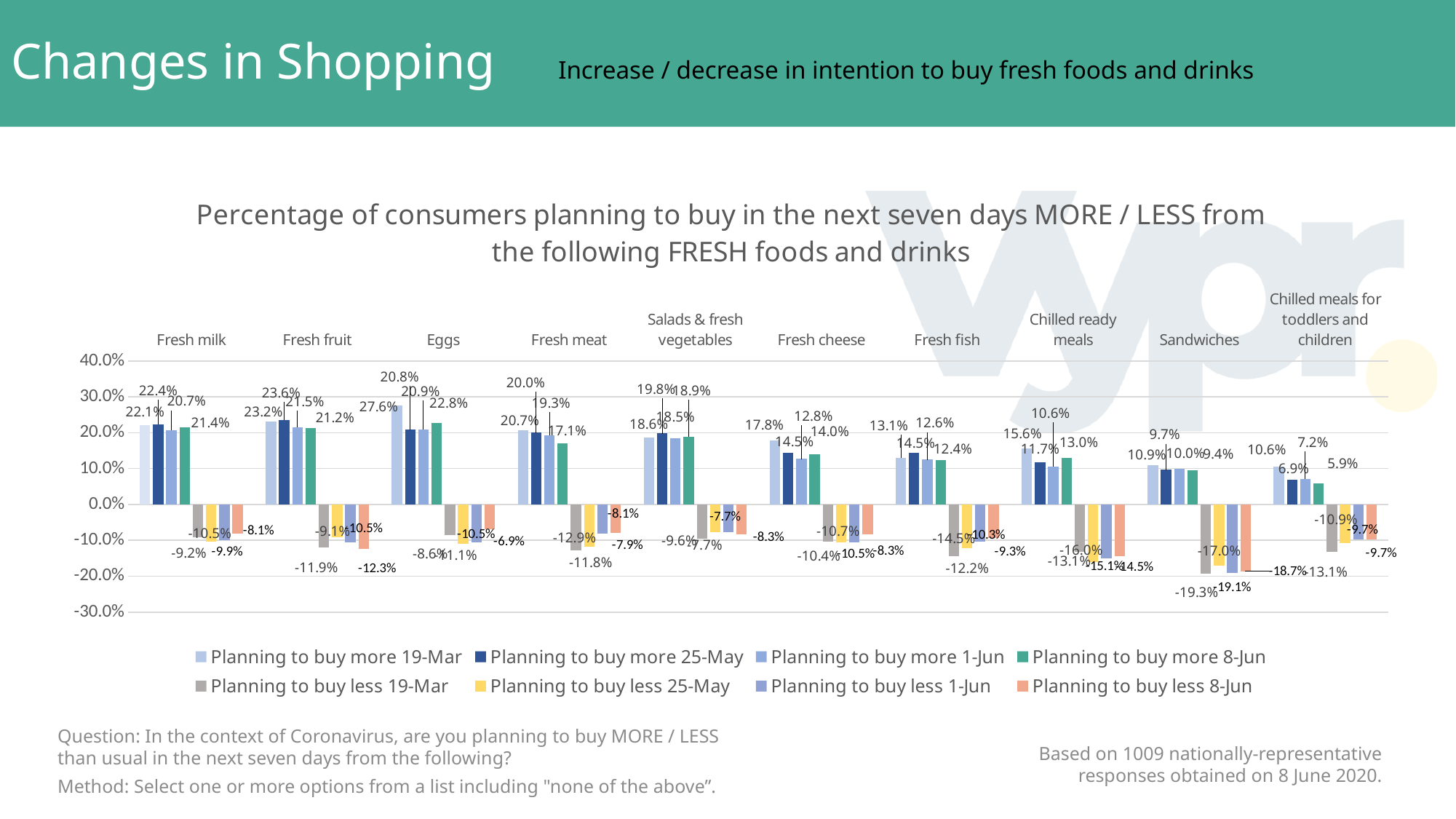
What is the value for Eggs in the 'Planning to buy more 19-Mar' series? 27.6% Which category has the highest value in the 'Planning to buy more 19-Mar' series? Eggs How many series does the legend list? 8 What is the value for Sandwiches in the 'Planning to buy less 19-Mar' series? -19.3% What is the title of the chart? Percentage of consumers planning to buy in the next seven days MORE / LESS from the following FRESH foods and drinks Which category has the lowest value in the 'Planning to buy more 8-Jun' series? Chilled meals for toddlers and children Is the 'Planning to buy more 19-Mar' value for Fresh fruit greater or less than 20.0%? greater Which is larger for Fresh meat: the 'Planning to buy more 19-Mar' value or the 'Planning to buy more 8-Jun' value? Planning to buy more 19-Mar What type of chart is shown on the slide? bar chart What is the difference between the 'Planning to buy more 19-Mar' values for Eggs and Fresh milk? 5.5% How many food and drink categories are shown on the x axis? 10 What is the value for Chilled meals for toddlers and children in the 'Planning to buy more 8-Jun' series? 5.9%